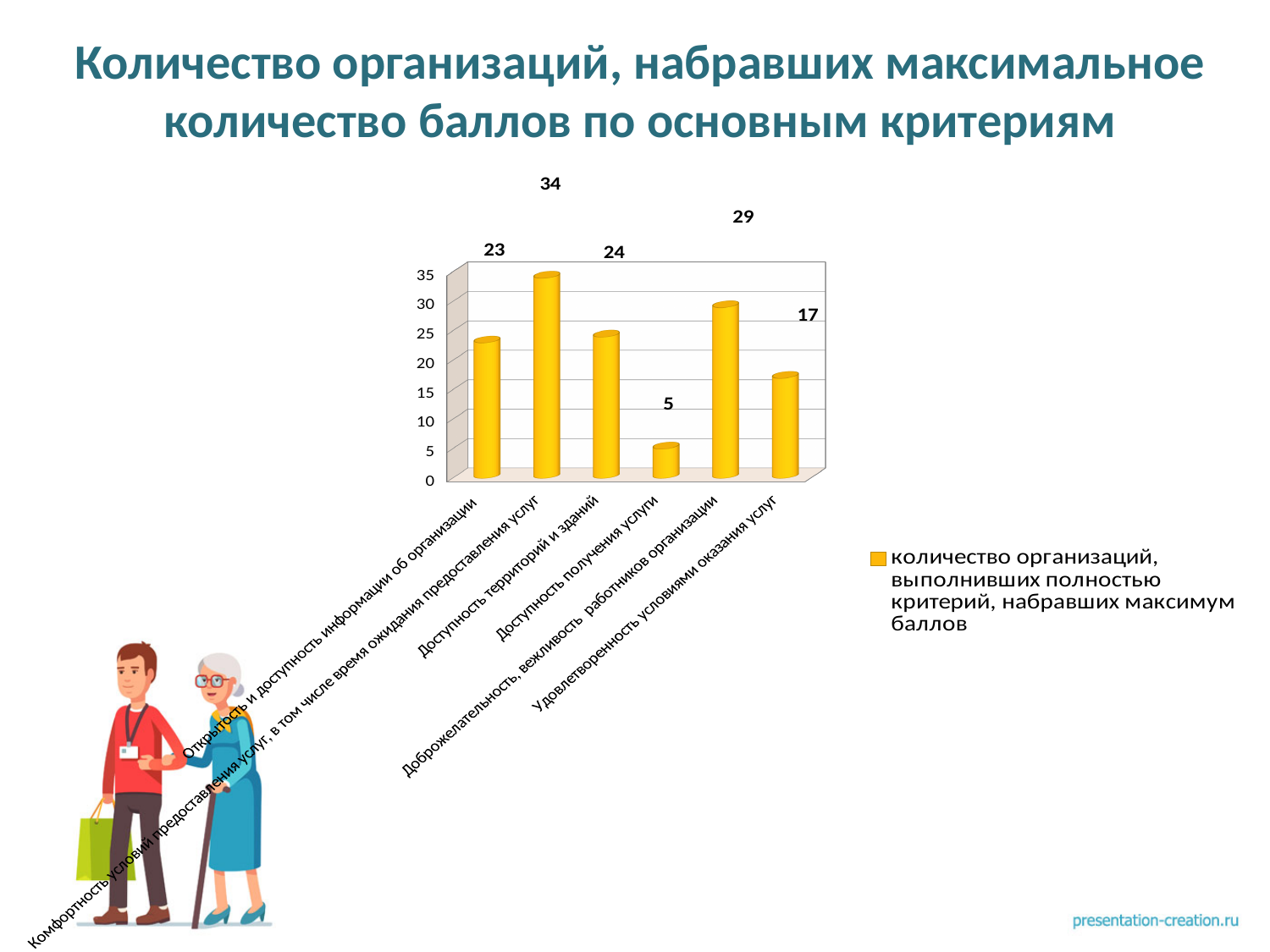
How many series does the legend list? 1 What is the value for "Удовлетворенность условиями оказания услуг"? 17 What is the title of the chart on the slide? Количество организаций, набравших максимальное количество баллов по основным критериям What type of chart is shown on the slide? bar chart Which category has the highest value? Комфортность условий предоставления услуг, в том числе время ожидания предоставления услуг What is the difference between the values for "Доброжелательность, вежливость работников организации" and "Удовлетворенность условиями оказания услуг"? 12 Which category has the lowest value? Доступность получения услуги What is the value for "Доступность территорий и зданий"? 24 Which is larger: the value for "Доступность территорий и зданий" or the value for "Открытость и доступность информации об организации"? Доступность территорий и зданий What is the value for "Доступность получения услуги"? 5 What is the value for "Открытость и доступность информации об организации"? 23 How many categories are plotted in the chart? 6